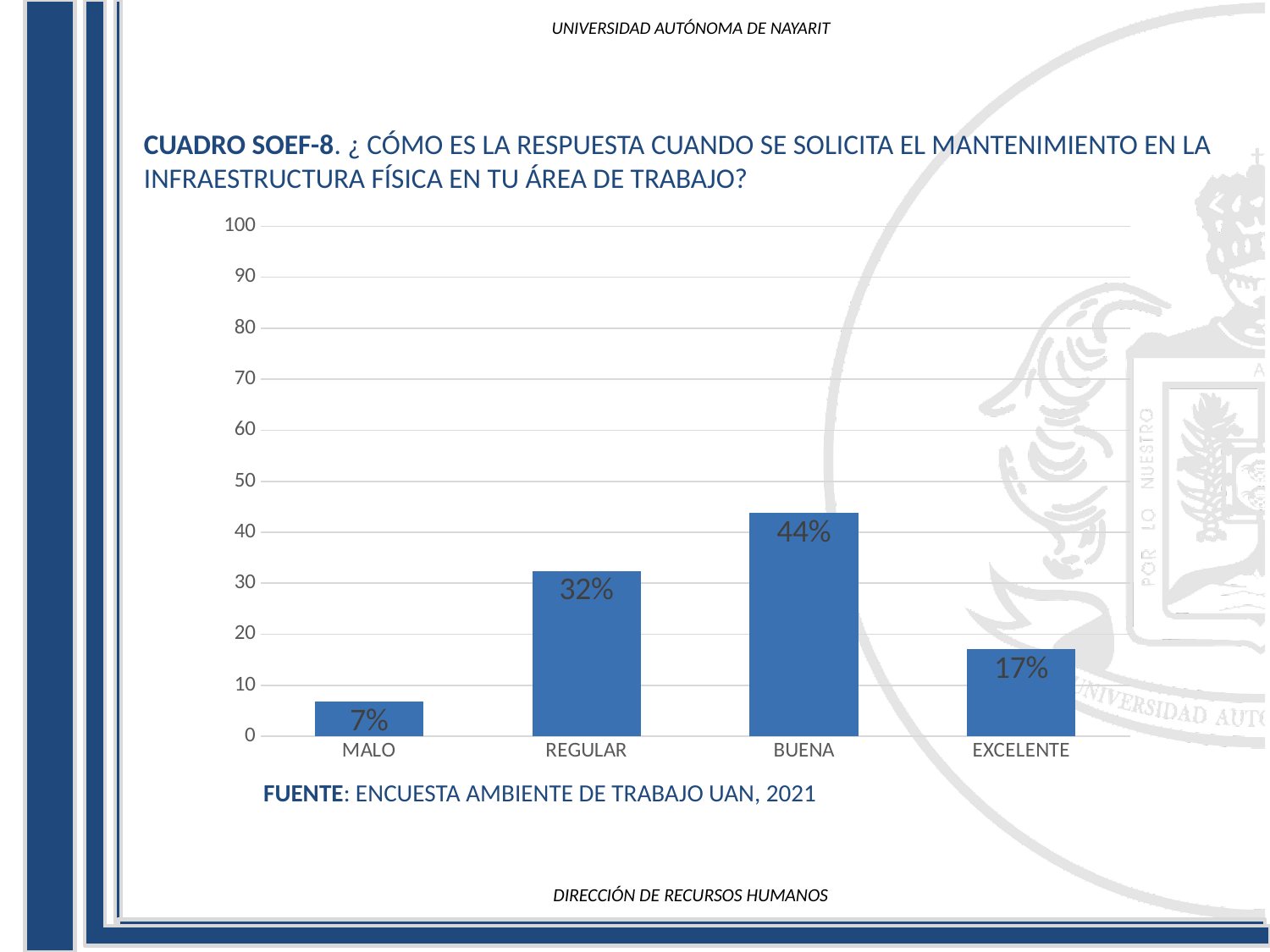
What is the source cited below the chart? ENCUESTA AMBIENTE DE TRABAJO UAN, 2021 How many categories are shown on the x axis? 4 What is the difference between the values for BUENA and REGULAR? 12% What is the value for MALO? 7% What is the highest tick value shown on the vertical axis? 100 Which category has the highest value? BUENA What kind of chart is shown on the slide? bar chart What is the value for BUENA? 44% What is the value for EXCELENTE? 17% Which category has the lowest value? MALO Is the value for REGULAR greater or less than 30? greater Which is larger, the value for REGULAR or the value for EXCELENTE? REGULAR